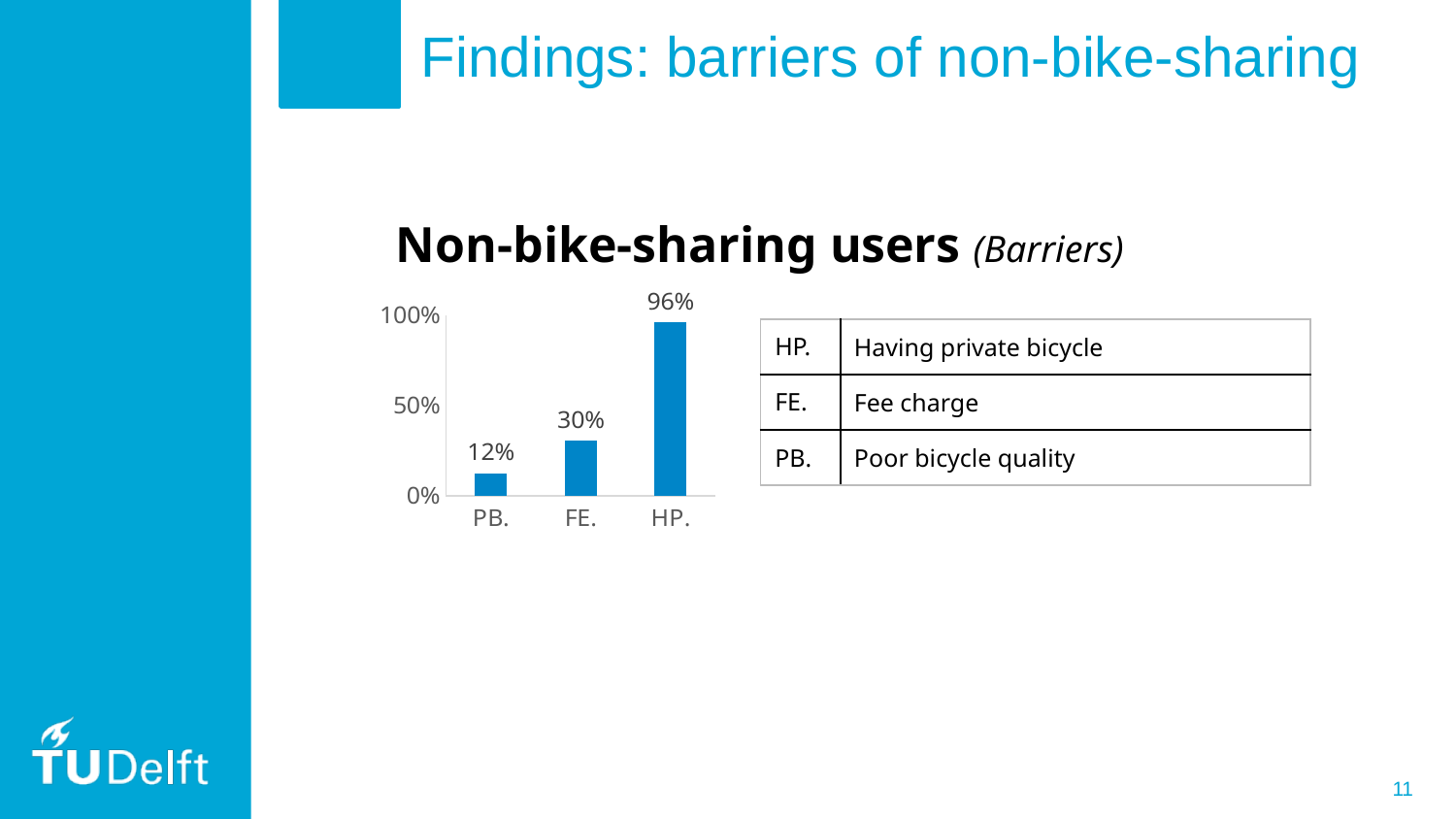
What is the difference between the values for FE. and PB. in the Non-bike-sharing users (Barriers) chart? 18% What is the value for FE. in the Non-bike-sharing users (Barriers) chart? 30% What is the difference between the values for HP. and FE. in the Non-bike-sharing users (Barriers) chart? 66% What is the value for PB. in the Non-bike-sharing users (Barriers) chart? 12% How many categories are shown in the Non-bike-sharing users (Barriers) chart? 3 Do the values rise or fall from left to right along the x axis in the Non-bike-sharing users (Barriers) chart? rise Is the value for HP. in the Non-bike-sharing users (Barriers) chart greater or less than 50%? greater What kind of chart is the Non-bike-sharing users (Barriers) chart? bar chart Which category has the highest value in the Non-bike-sharing users (Barriers) chart? HP. Which is larger in the Non-bike-sharing users (Barriers) chart, the value for FE. or the value for PB.? FE. Which category has the lowest value in the Non-bike-sharing users (Barriers) chart? PB. What is the value for HP. in the Non-bike-sharing users (Barriers) chart? 96%